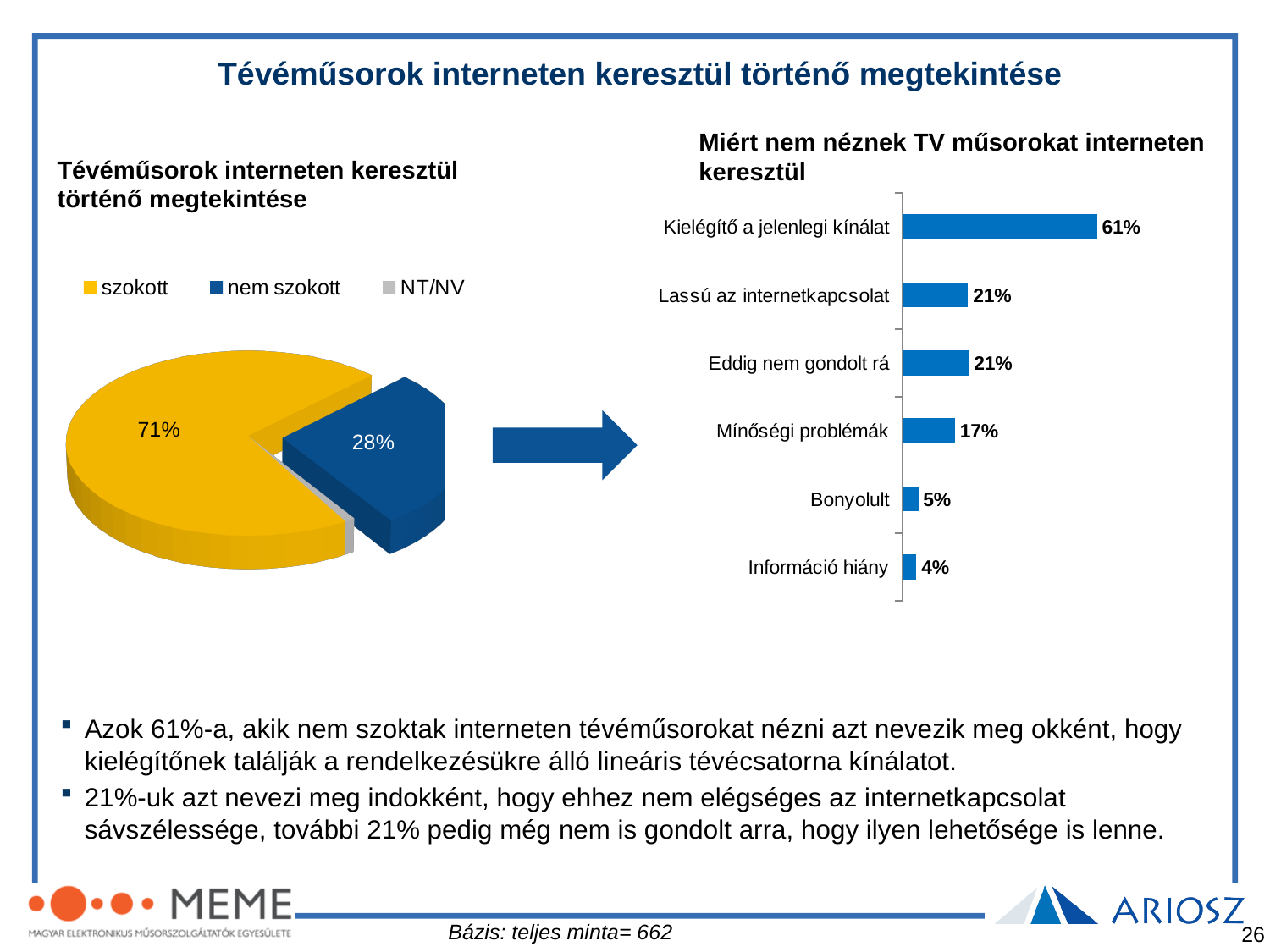
What kind of chart is the chart on the left of the slide? Pie chart In the pie chart on the left, what share is labelled for the 'nem szokott' slice? 28% In the chart 'Miért nem néznek TV műsorokat interneten keresztül', which category has the lowest value? Információ hiány In the chart 'Miért nem néznek TV műsorokat interneten keresztül', how many categories are shown? 6 In the chart 'Miért nem néznek TV műsorokat interneten keresztül', which is larger: 'Bonyolult' or 'Információ hiány'? Bonyolult In the chart 'Miért nem néznek TV műsorokat interneten keresztül', what is the difference between 'Kielégítő a jelenlegi kínálat' and 'Lassú az internetkapcsolat'? 40% In the chart 'Miért nem néznek TV műsorokat interneten keresztül', what is the value for 'Mínőségi problémák'? 17% What kind of chart is the chart titled 'Miért nem néznek TV műsorokat interneten keresztül'? Bar chart In the pie chart on the left, which slice is the largest? szokott How many entries does the legend of the pie chart on the left list? 3 In the pie chart on the left, what share is labelled for the 'szokott' slice? 71% In the chart 'Miért nem néznek TV műsorokat interneten keresztül', what is the value for 'Kielégítő a jelenlegi kínálat'? 61%